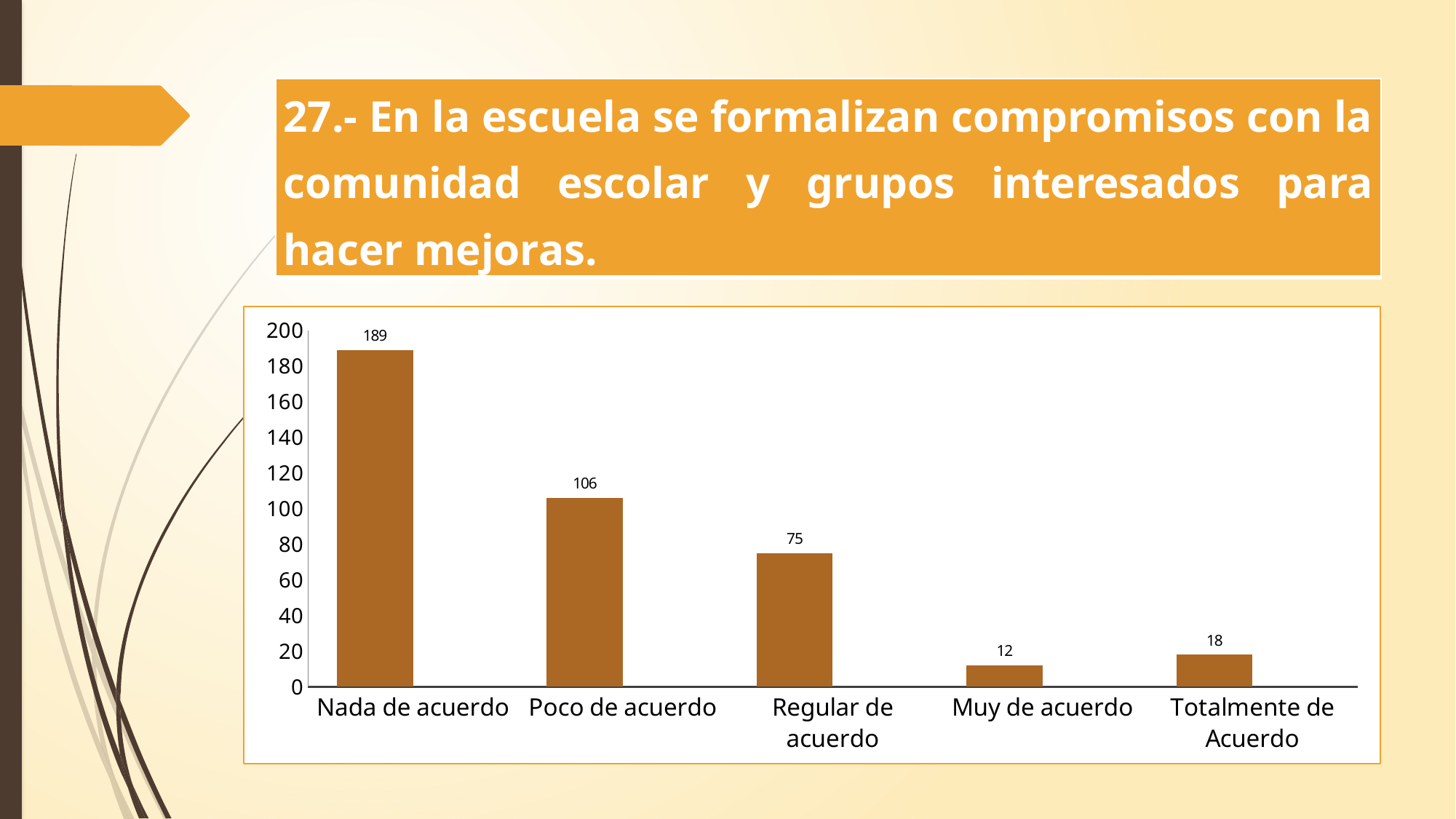
What is the value for "Muy de acuerdo"? 12 What is the value for "Regular de acuerdo"? 75 What kind of chart is shown on the slide? bar chart What is the value for "Totalmente de Acuerdo"? 18 What is the difference between the values for "Nada de acuerdo" and "Poco de acuerdo"? 83 How many categories are shown on the x axis? 5 Is the value for "Regular de acuerdo" greater or less than 80? less Which is larger, the value for "Totalmente de Acuerdo" or the value for "Muy de acuerdo"? Totalmente de Acuerdo Which category has the highest value? Nada de acuerdo What is the value for "Poco de acuerdo"? 106 Which category has the lowest value? Muy de acuerdo What is the value for "Nada de acuerdo"? 189